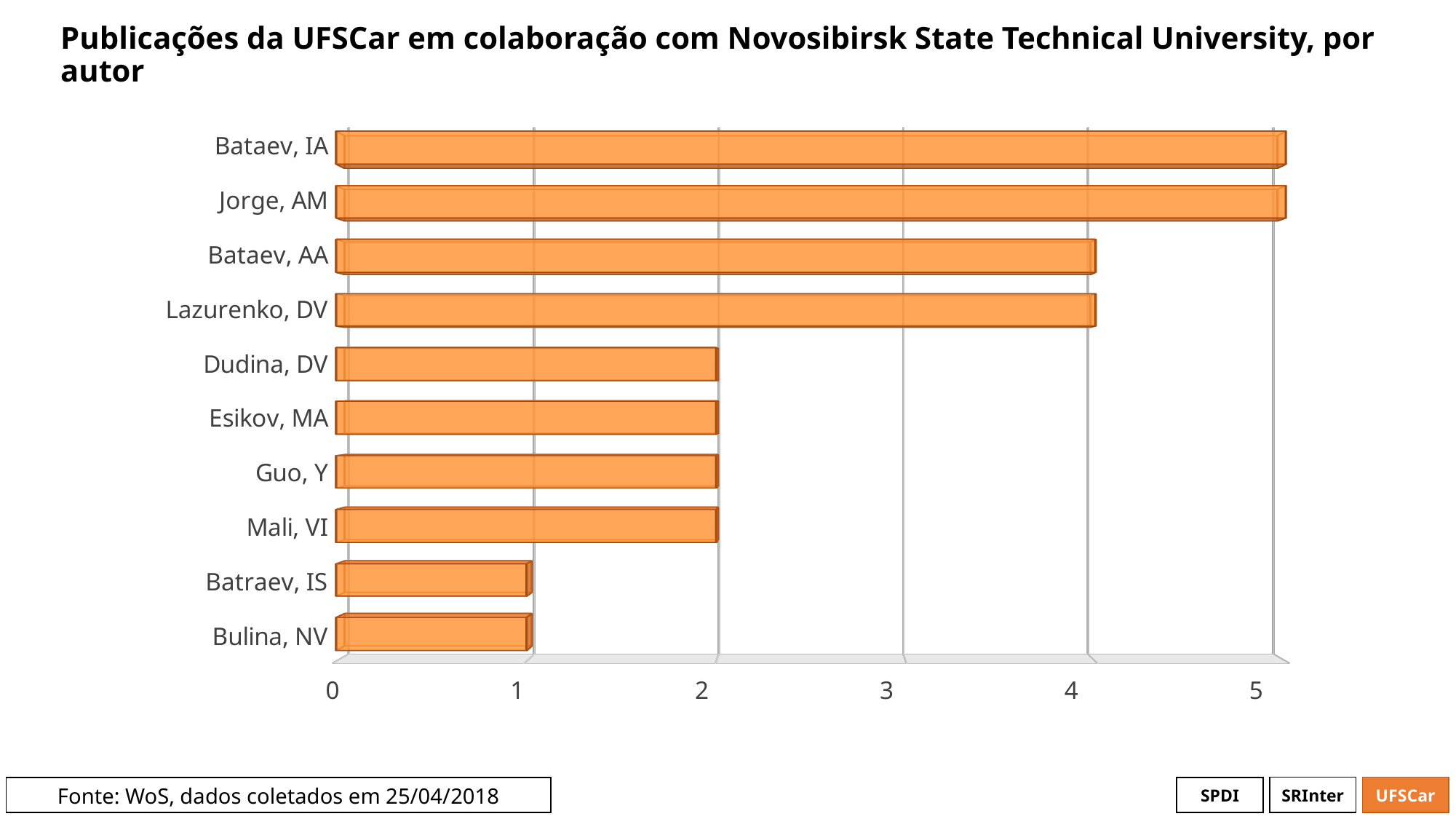
How many publications does Jorge, AM have? 5 How many publications does Bulina, NV have? 1 Which author has the fewest publications, Batraev, IS or Mali, VI? Batraev, IS How many publications does Bataev, AA have? 4 What is the difference in publications between Bataev, IA and Esikov, MA? 3 What kind of chart is shown on the slide? bar chart How many authors are listed on the chart? 10 What is the source of the data cited on the slide? WoS, dados coletados em 25/04/2018 Who has more publications, Lazurenko, DV or Dudina, DV? Lazurenko, DV Is the value for Lazurenko, DV greater or less than 3? greater How many publications does Guo, Y have? 2 Is the value for Mali, VI greater or less than 3? less